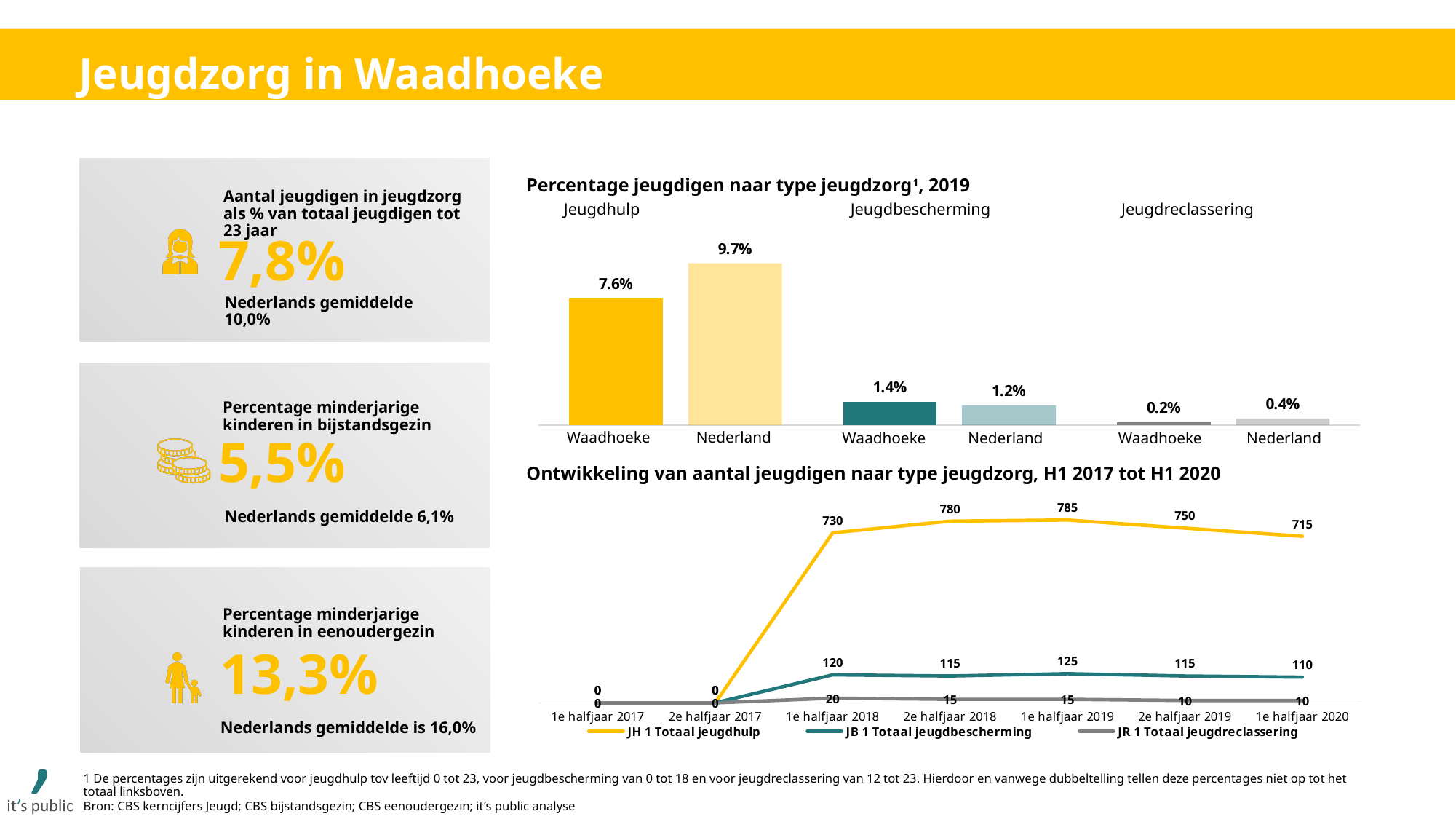
In the bar chart 'Percentage jeugdigen naar type jeugdzorg, 2019', is the Jeugdbescherming value higher for Waadhoeke or for Nederland? Waadhoeke In the bar chart 'Percentage jeugdigen naar type jeugdzorg, 2019', what is the Jeugdbescherming value for Nederland? 1.2% In the line chart 'Ontwikkeling van aantal jeugdigen naar type jeugdzorg, H1 2017 tot H1 2020', what is the value of JB 1 Totaal jeugdbescherming in 1e halfjaar 2020? 110 In the bar chart 'Percentage jeugdigen naar type jeugdzorg, 2019', what is the Jeugdhulp value for Waadhoeke? 7.6% In the bar chart 'Percentage jeugdigen naar type jeugdzorg, 2019', which bar is the highest? Nederland (Jeugdhulp), 9.7% In the line chart 'Ontwikkeling van aantal jeugdigen naar type jeugdzorg, H1 2017 tot H1 2020', how many time points are shown on the x axis? 7 In the line chart 'Ontwikkeling van aantal jeugdigen naar type jeugdzorg, H1 2017 tot H1 2020', what is the value of JH 1 Totaal jeugdhulp in 1e halfjaar 2019? 785 In the bar chart 'Percentage jeugdigen naar type jeugdzorg, 2019', what is the difference between the Jeugdhulp values for Nederland and Waadhoeke? 2.1% In the line chart 'Ontwikkeling van aantal jeugdigen naar type jeugdzorg, H1 2017 tot H1 2020', does JH 1 Totaal jeugdhulp rise or fall from 1e halfjaar 2019 to 1e halfjaar 2020? Fall What type of chart is 'Percentage jeugdigen naar type jeugdzorg, 2019'? Bar chart In the bar chart 'Percentage jeugdigen naar type jeugdzorg, 2019', which bar is the lowest? Waadhoeke (Jeugdreclassering), 0.2% In the line chart 'Ontwikkeling van aantal jeugdigen naar type jeugdzorg, H1 2017 tot H1 2020', how many series does the legend list? 3